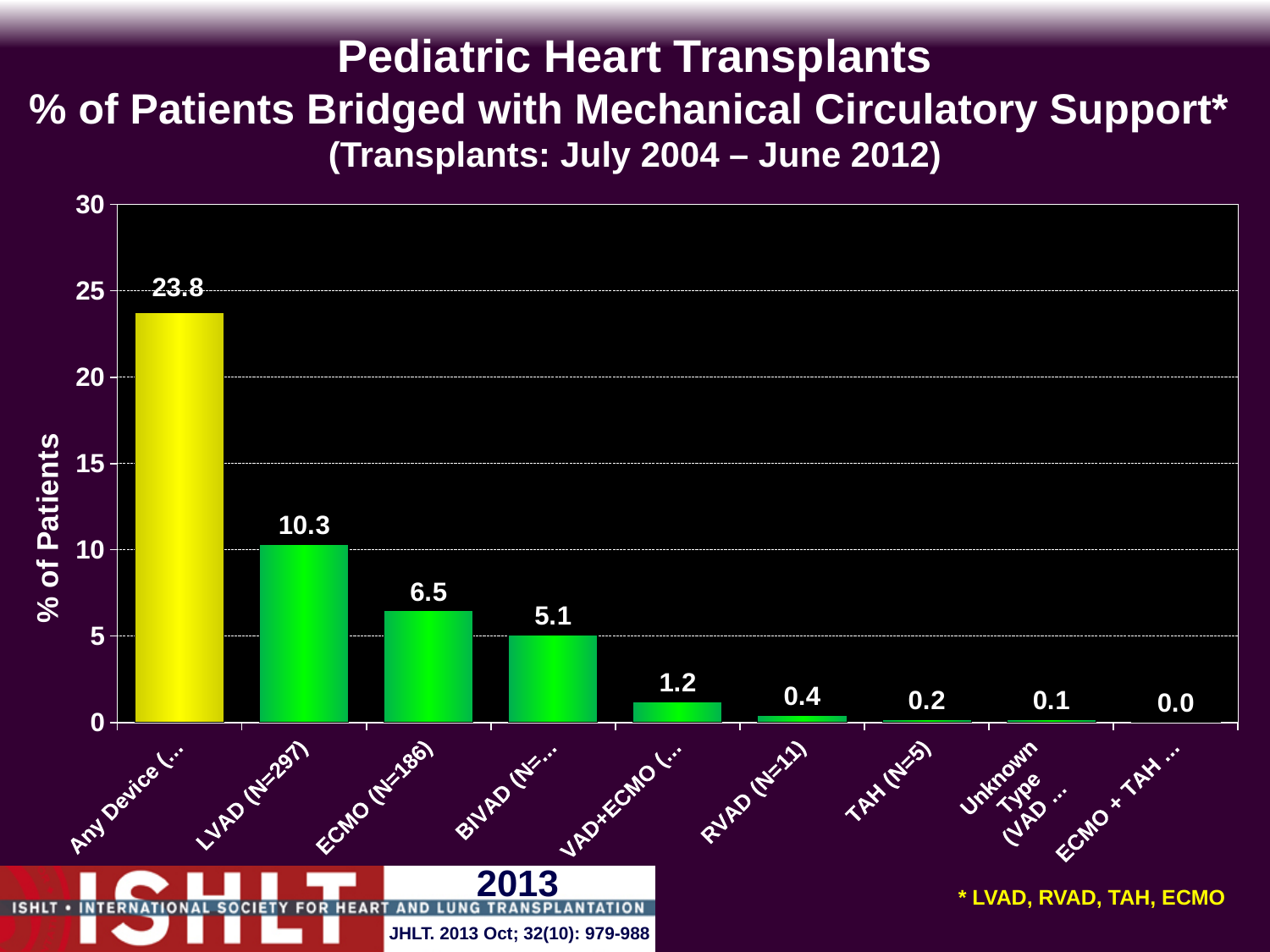
What is the value for RVAD (N=11)? 0.4 What is the value for LVAD (N=297)? 10.3 What is the value for ECMO (N=186)? 6.5 Which is larger, the value for BIVAD or the value for VAD+ECMO? BIVAD How many categories are shown on the x axis? 9 What is the label of the y axis? % of Patients Which category has the highest value? Any Device What kind of chart is shown on the slide? bar chart Which category has the lowest value? ECMO + TAH Is the value for Any Device greater or less than 20? greater What is the difference between the values for LVAD (N=297) and ECMO (N=186)? 3.8 What is the value for TAH (N=5)? 0.2